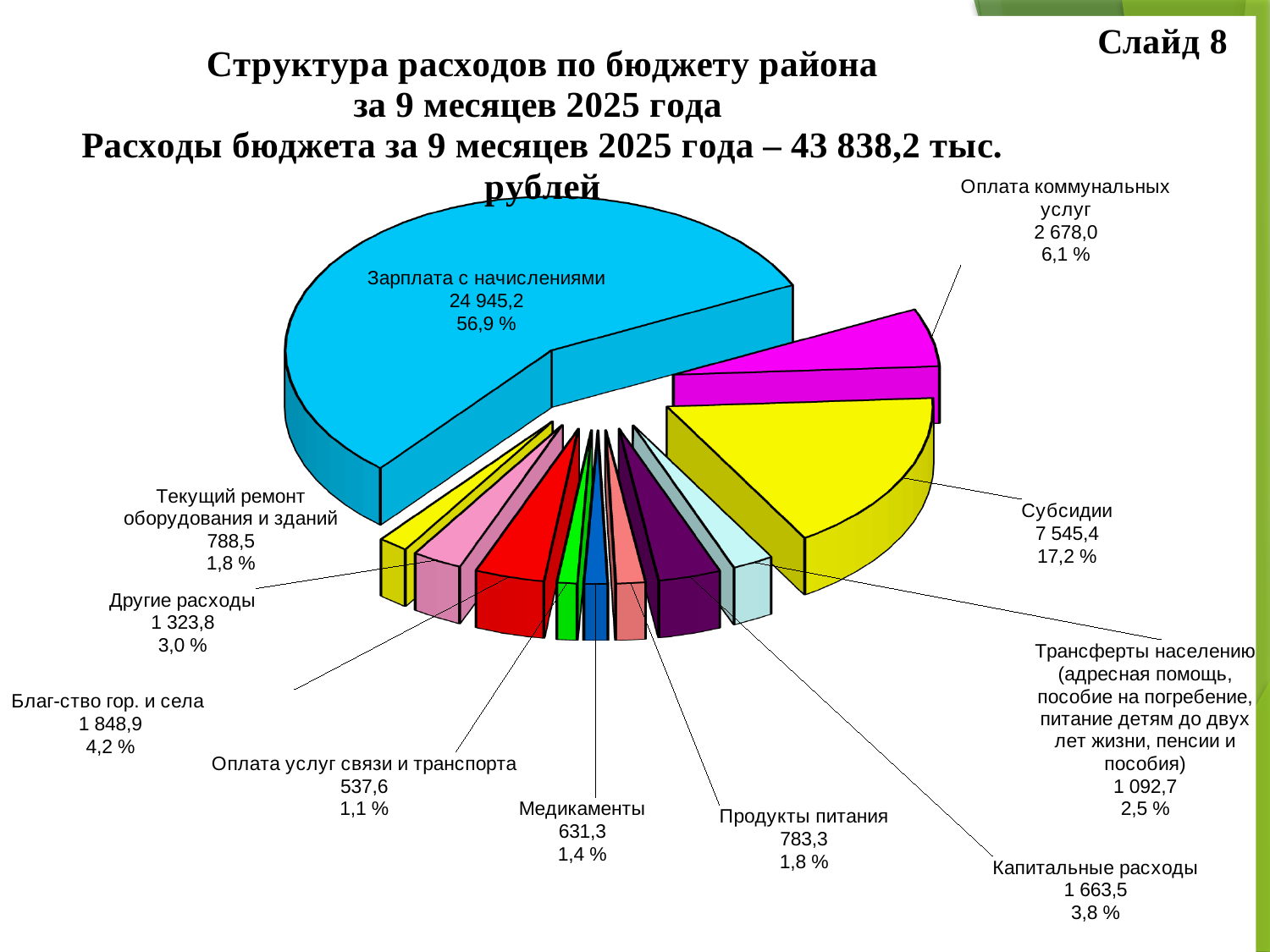
Which category has the smallest slice of the pie? Оплата услуг связи и транспорта What kind of chart is shown on the slide? Pie chart What total budget expenditure is stated in the chart title? 43 838,2 тыс. рублей What share of the pie does Капитальные расходы take? 3,8 % What is the value for Зарплата с начислениями? 24 945,2 What is the value for Оплата коммунальных услуг? 2 678,0 Which category has the largest slice of the pie? Зарплата с начислениями What share of the pie does Субсидии take? 17,2 % What is the difference between the values for Субсидии and Оплата коммунальных услуг? 4 867,4 What is the value for Медикаменты? 631,3 How many categories are shown in the pie chart? 11 Which is larger, the value for Благ-ство гор. и села or the value for Другие расходы? Благ-ство гор. и села